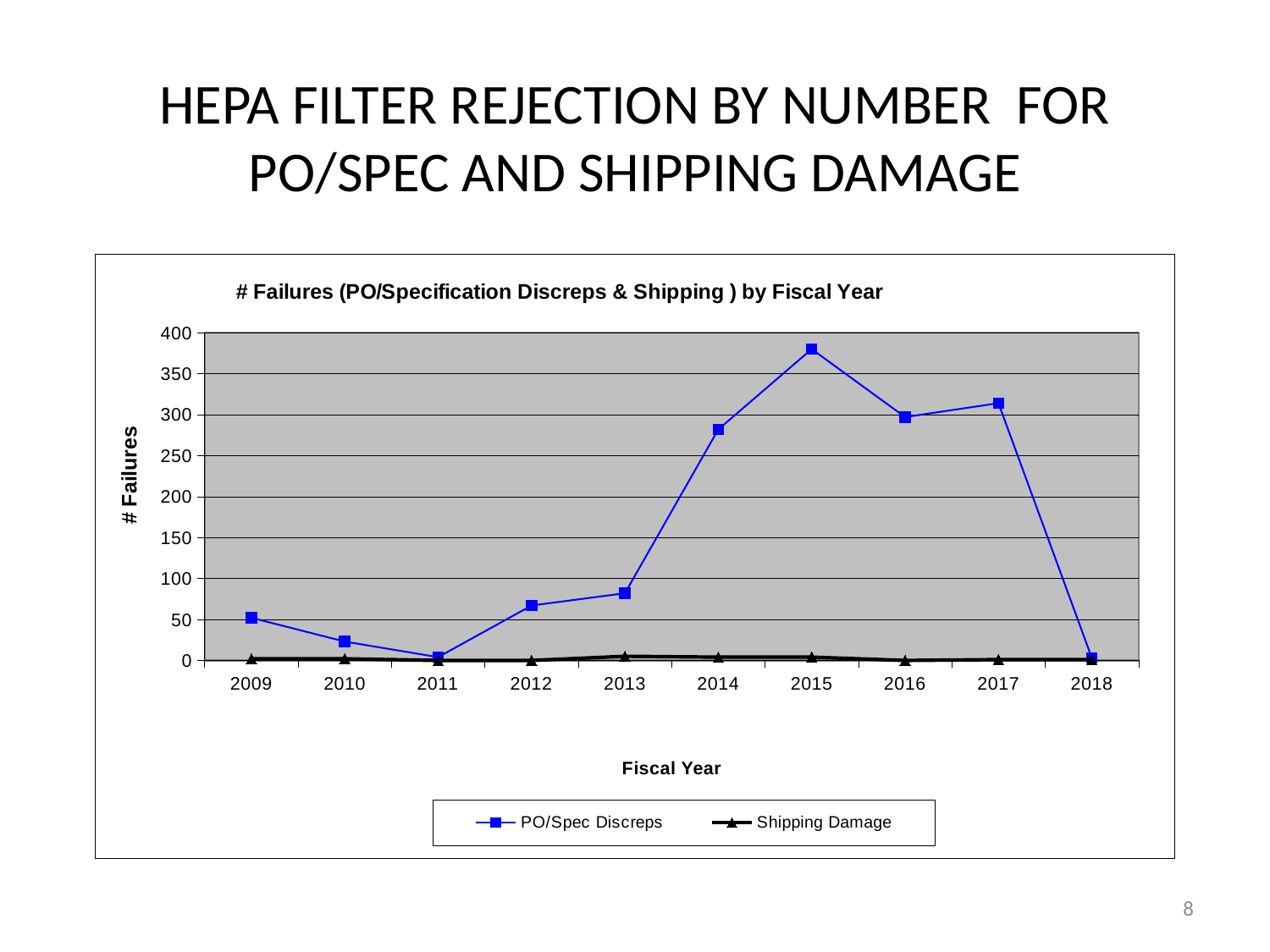
What kind of chart is shown on the slide? line chart In which fiscal year is the PO/Spec Discreps value highest? 2015 Which year has the larger PO/Spec Discreps value, 2009 or 2010? 2009 Do the PO/Spec Discreps values rise or fall from 2011 to 2015? rise Is the PO/Spec Discreps value for 2015 greater or less than 350? greater Which year has the larger PO/Spec Discreps value, 2013 or 2014? 2014 Is the PO/Spec Discreps value for 2010 greater or less than 50? less Is the PO/Spec Discreps value for 2014 greater or less than 250? greater How many series does the legend list? 2 What is the label on the x axis of the chart? Fiscal Year How many fiscal years are plotted on the x axis? 10